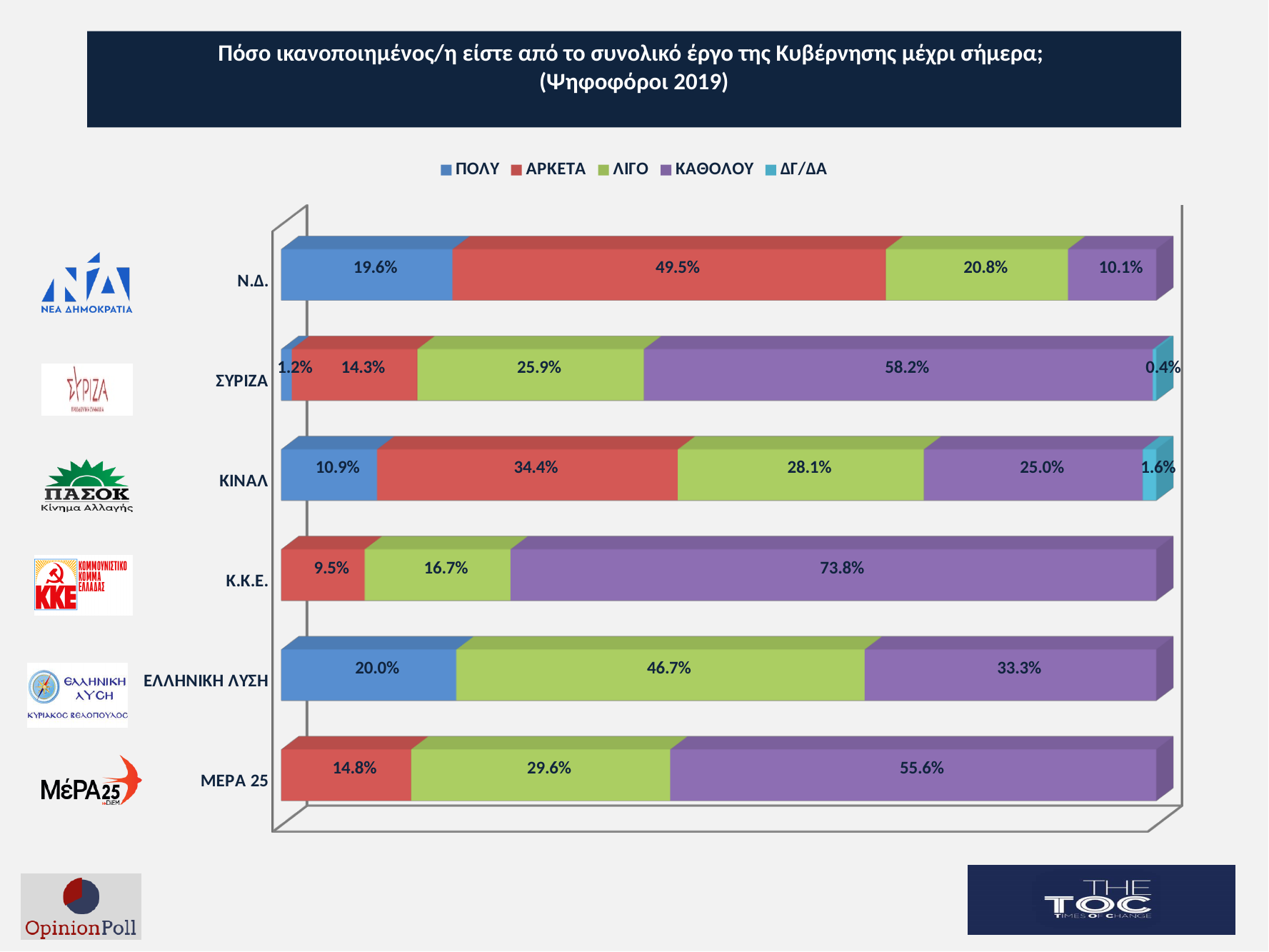
What type of chart is shown on the slide? Stacked bar chart Which is larger: the ΠΟΛΥ value for Ν.Δ. or the ΠΟΛΥ value for ΚΙΝΑΛ? Ν.Δ. What is the difference between the ΚΑΘΟΛΟΥ values for ΣΥΡΙΖΑ and ΜΕΡΑ 25? 2.6% Which party has the highest ΚΑΘΟΛΟΥ value? Κ.Κ.Ε. Which legend entry is shown in purple? ΚΑΘΟΛΟΥ What is the ΛΙΓΟ value for ΕΛΛΗΝΙΚΗ ΛΥΣΗ? 46.7% How many series does the legend list? 5 Which party has the lowest ΚΑΘΟΛΟΥ value? Ν.Δ. What is the ΚΑΘΟΛΟΥ value for ΣΥΡΙΖΑ? 58.2% What is the ΑΡΚΕΤΑ value for Ν.Δ.? 49.5% What is the ΔΓ/ΔΑ value for ΚΙΝΑΛ? 1.6% How many parties (categories) are shown in the chart? 6